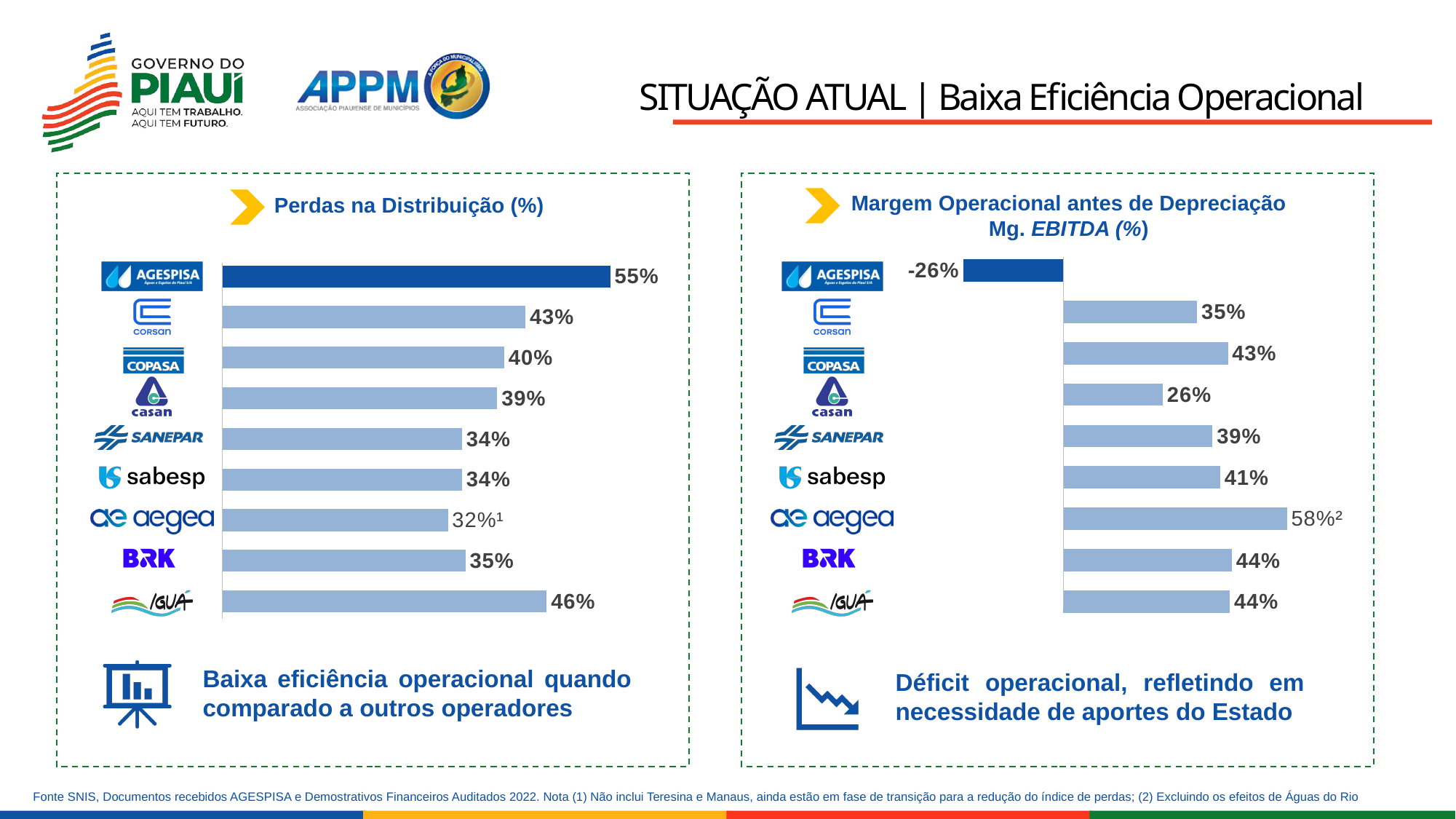
In the 'Margem Operacional antes de Depreciação Mg. EBITDA (%)' chart, which operator has the highest value? Aegea In the 'Margem Operacional antes de Depreciação Mg. EBITDA (%)' chart, what is the value for Casan? 26% In the 'Margem Operacional antes de Depreciação Mg. EBITDA (%)' chart, which is larger, COPASA or Corsan? COPASA In the 'Margem Operacional antes de Depreciação Mg. EBITDA (%)' chart, what is the value for AGESPISA? -26% In the 'Perdas na Distribuição (%)' chart, how many operators are shown? 9 In the 'Perdas na Distribuição (%)' chart, which operator has the lowest value? Aegea In the 'Perdas na Distribuição (%)' chart, which operator has the highest value? AGESPISA In the 'Margem Operacional antes de Depreciação Mg. EBITDA (%)' chart, which operator has the lowest value? AGESPISA What type of chart is the 'Perdas na Distribuição (%)' chart? Bar chart In the 'Perdas na Distribuição (%)' chart, what is the difference between AGESPISA and Iguá? 9 percentage points In the 'Perdas na Distribuição (%)' chart, what is the value for AGESPISA? 55% In the 'Margem Operacional antes de Depreciação Mg. EBITDA (%)' chart, what is the difference between BRK and Sanepar? 5 percentage points